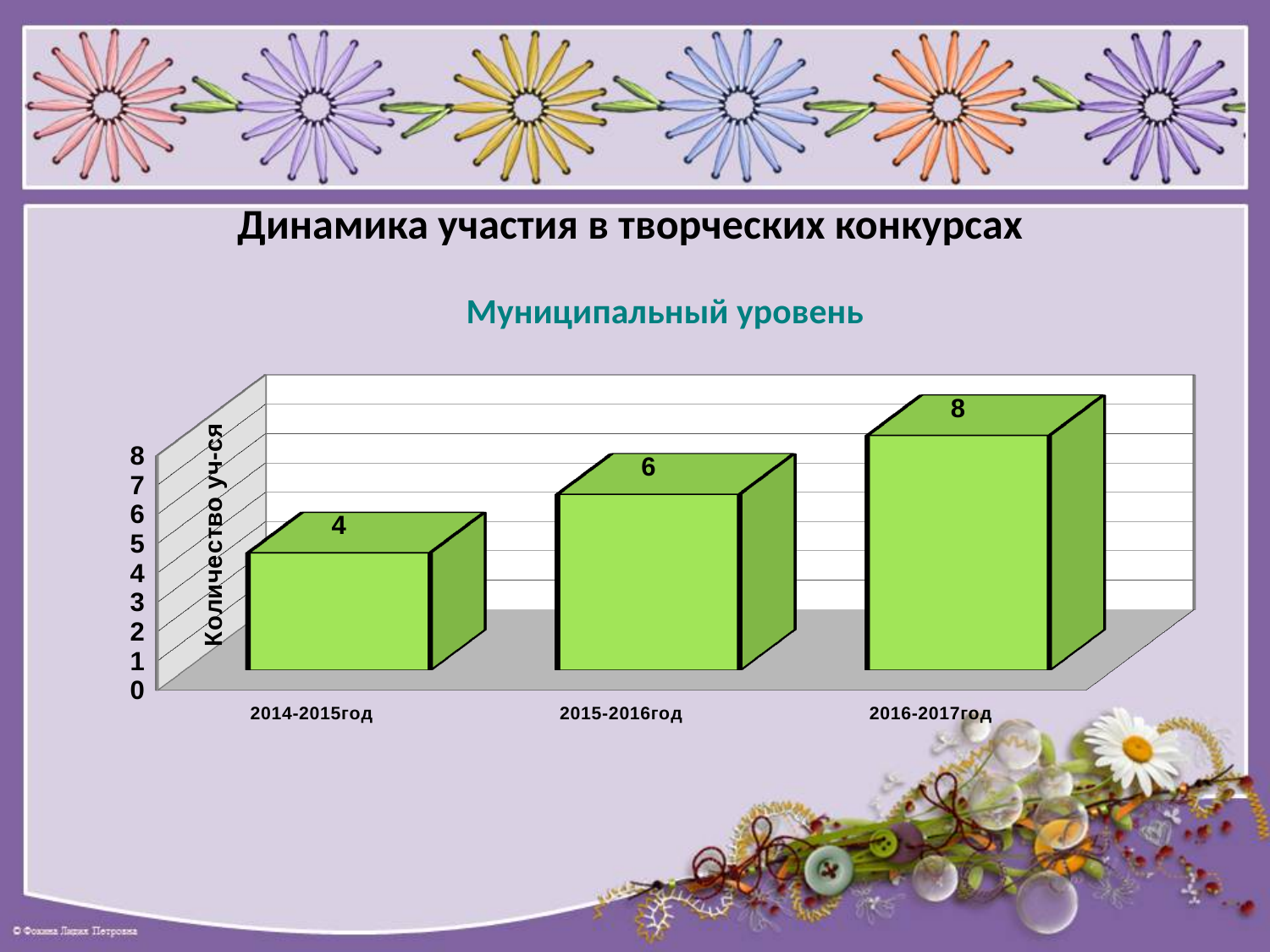
What kind of chart is shown? bar chart Which year has the highest value? 2016-2017год What is the label of the vertical axis? Количество уч-ся How many categories are shown on the x axis? 3 Which is larger, the value for 2015-2016год or 2014-2015год? 2015-2016год What is the difference between the values for 2016-2017год and 2014-2015год? 4 What is the value for 2016-2017год? 8 What is the value for 2015-2016год? 6 What is the value for 2014-2015год? 4 Which year has the lowest value? 2014-2015год Do the values rise or fall from 2014-2015год to 2016-2017год? rise What is the difference between the values for 2015-2016год and 2014-2015год? 2